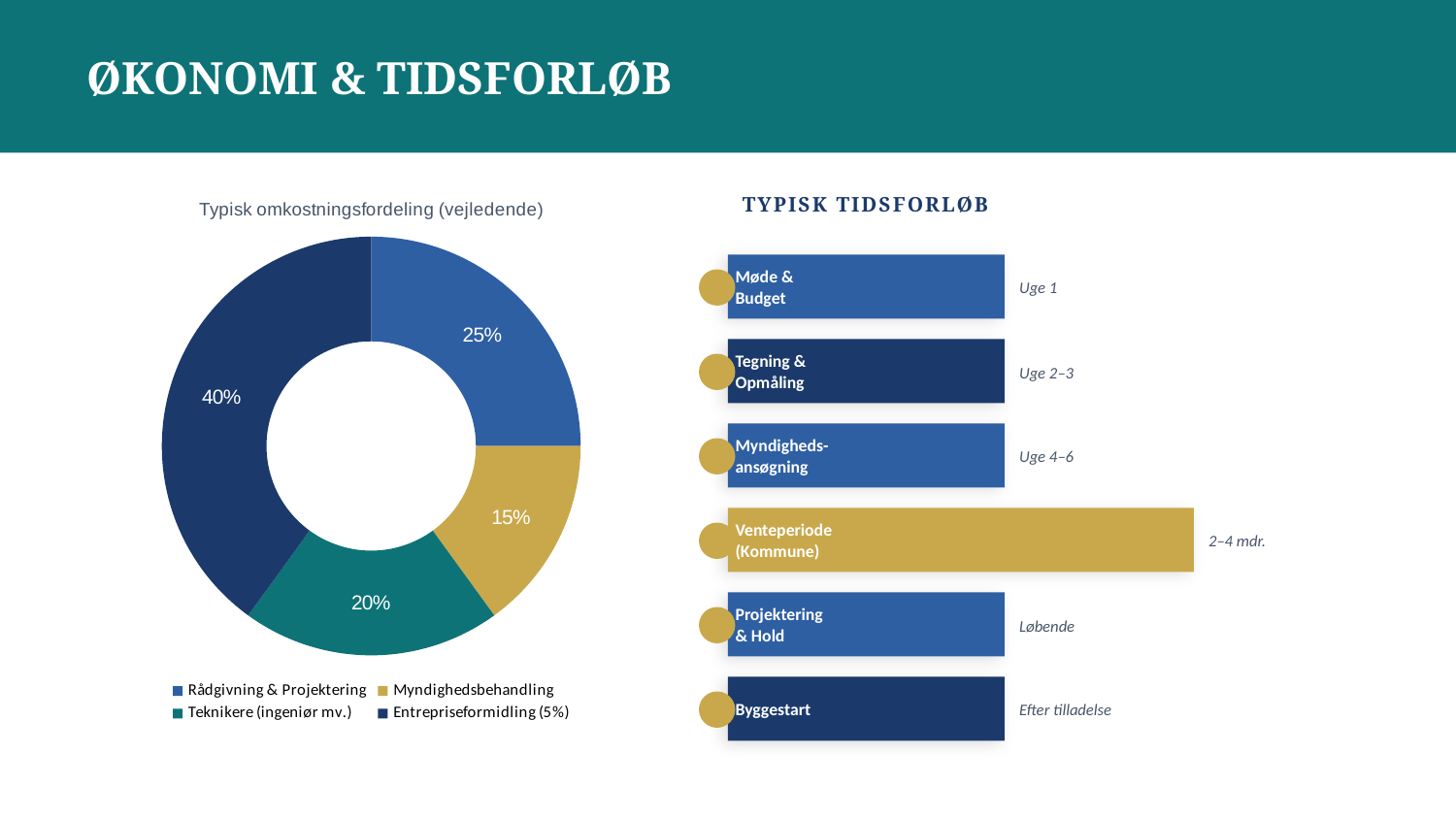
What is the title of the doughnut chart on the left of the slide? Typisk omkostningsfordeling (vejledende) In the doughnut chart, what share is shown for Myndighedsbehandling? 15% In the doughnut chart, what share is shown for Teknikere (ingeniør mv.)? 20% In the doughnut chart, what share is shown for Rådgivning & Projektering? 25% In the doughnut chart, which is larger: Teknikere (ingeniør mv.) or Rådgivning & Projektering? Rådgivning & Projektering What colour is the Myndighedsbehandling slice in the doughnut chart? Gold Which category has the smallest slice in the doughnut chart? Myndighedsbehandling In the doughnut chart, what share is shown for the slice labelled Entrepriseformidling (5%) in the legend? 40% Which category has the largest slice in the doughnut chart? Entrepriseformidling (5%) What kind of chart is shown on the left of the slide? Doughnut chart How many slices does the doughnut chart have? 4 In the doughnut chart, what is the difference in percentage points between Rådgivning & Projektering and Myndighedsbehandling? 10 percentage points